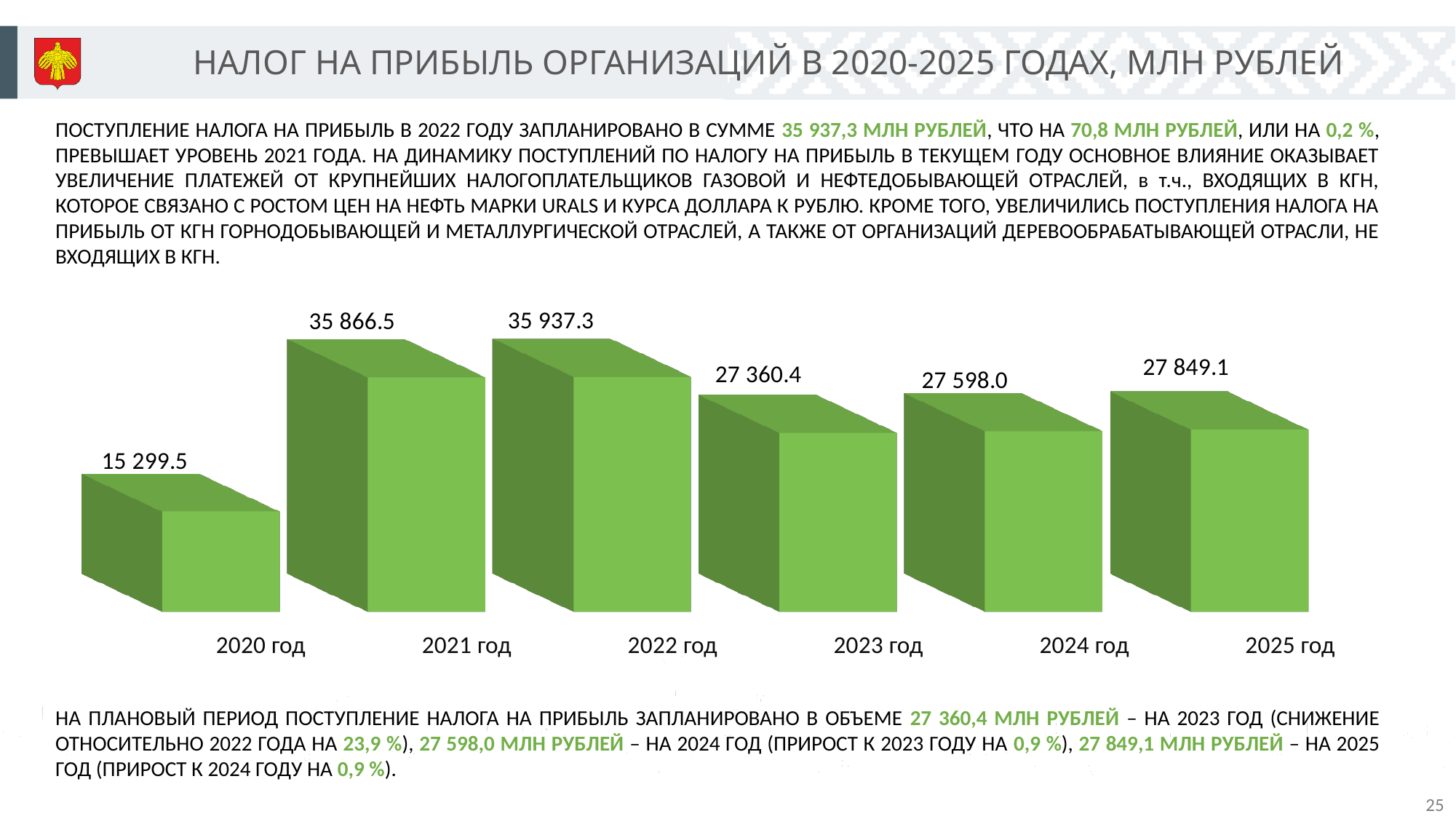
What is the title of the slide's chart? НАЛОГ НА ПРИБЫЛЬ ОРГАНИЗАЦИЙ В 2020-2025 ГОДАХ, МЛН РУБЛЕЙ What is the value shown for 2022 год? 35 937.3 What is the difference between the values for 2025 год and 2024 год? 251.1 Which year has the highest value on the chart? 2022 год What is the value shown for 2024 год? 27 598.0 What is the value shown for 2020 год? 15 299.5 Do the values rise or fall from 2023 год to 2025 год? rise Which is larger, the value for 2023 год or the value for 2024 год? 2024 год What kind of chart is shown on the slide? bar chart How many years (bars) are shown on the chart? 6 What is the difference between the values for 2022 год and 2021 год? 70.8 Which year has the lowest value on the chart? 2020 год